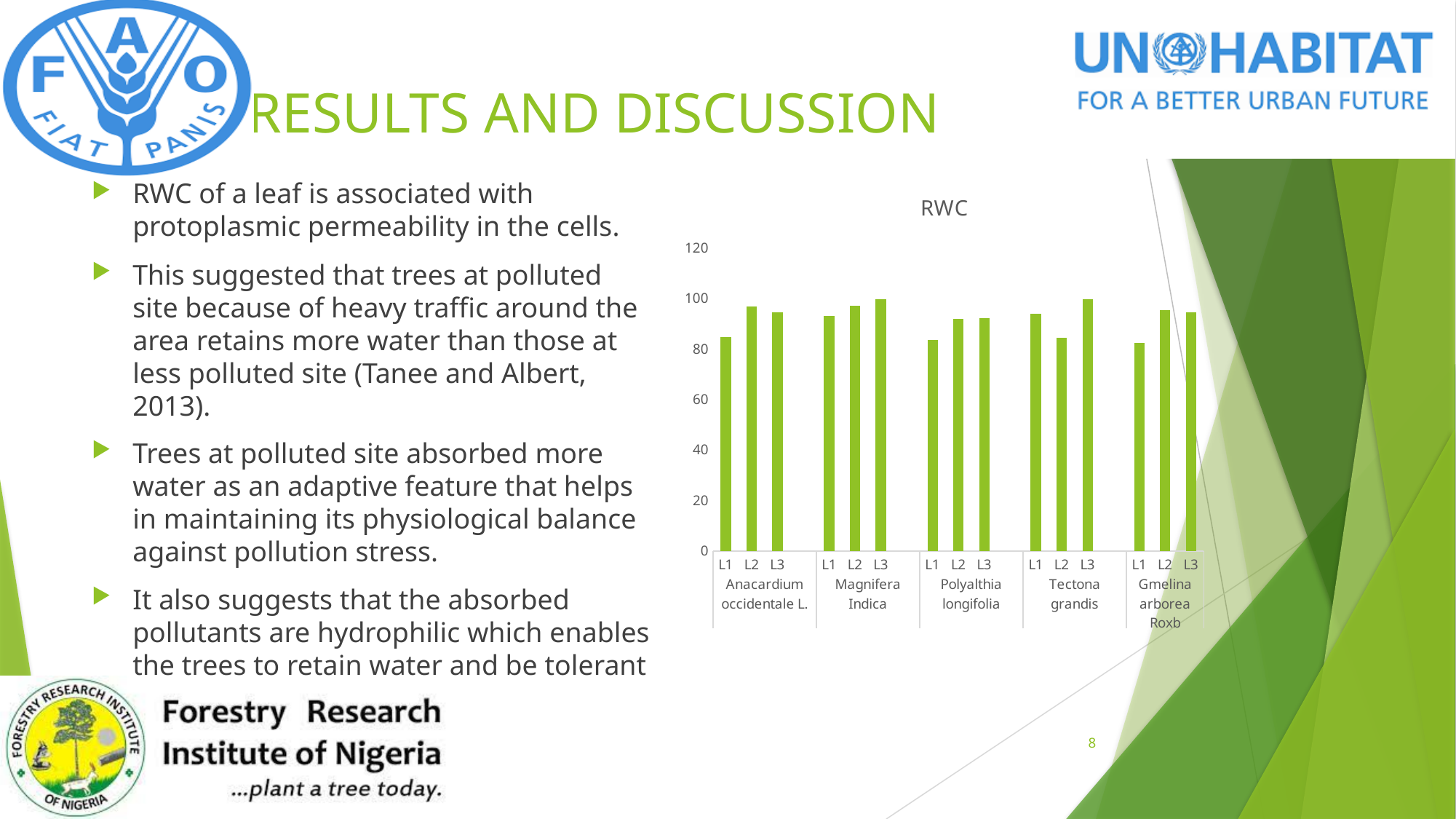
For Gmelina arborea Roxb, which is larger, the value at L1 or at L2? L2 For Anacardium occidentale L., which is larger, the value at L1 or at L2? L2 What kind of chart is shown on the slide? bar chart Is the value for Gmelina arborea Roxb at L1 greater or less than 60? greater Is the value for Anacardium occidentale L. at L1 greater or less than 80? greater For Tectona grandis, which location has the lowest RWC value? L2 What is the title of the chart? RWC Is the value for Anacardium occidentale L. at L1 greater or less than 100? less How many tree species are shown on the x axis of the chart? 5 How many bars are plotted in the chart in total? 15 For Magnifera Indica, do the values rise or fall from L1 to L3? rise For Tectona grandis, which location has the highest RWC value? L3